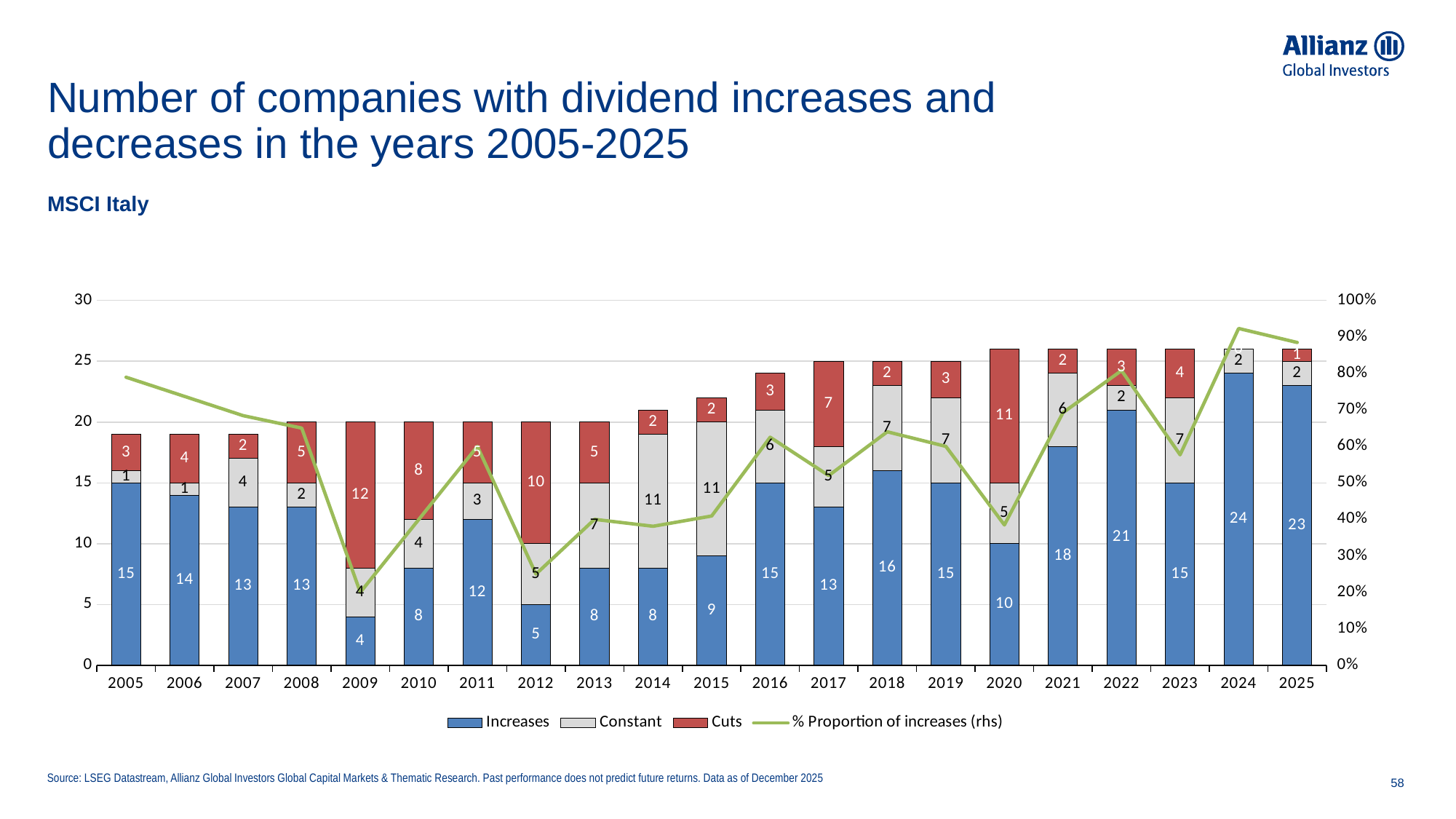
What is the difference between the Increases value in 2024 and in 2009? 20 Which year has the larger Cuts value, 2020 or 2017? 2020 In which year is the Increases value highest? 2024 How many series does the legend list? 4 In which year is the Increases value lowest? 2009 What is the value for Cuts in 2009? 12 What is the value for Constant in 2014? 11 In which year is the Cuts value highest? 2009 How many years are shown on the x axis? 21 Is the % Proportion of increases for 2024 greater or less than 90%? greater What is the total height of the stacked bar for 2020? 26 How many companies had dividend increases in 2022? 21